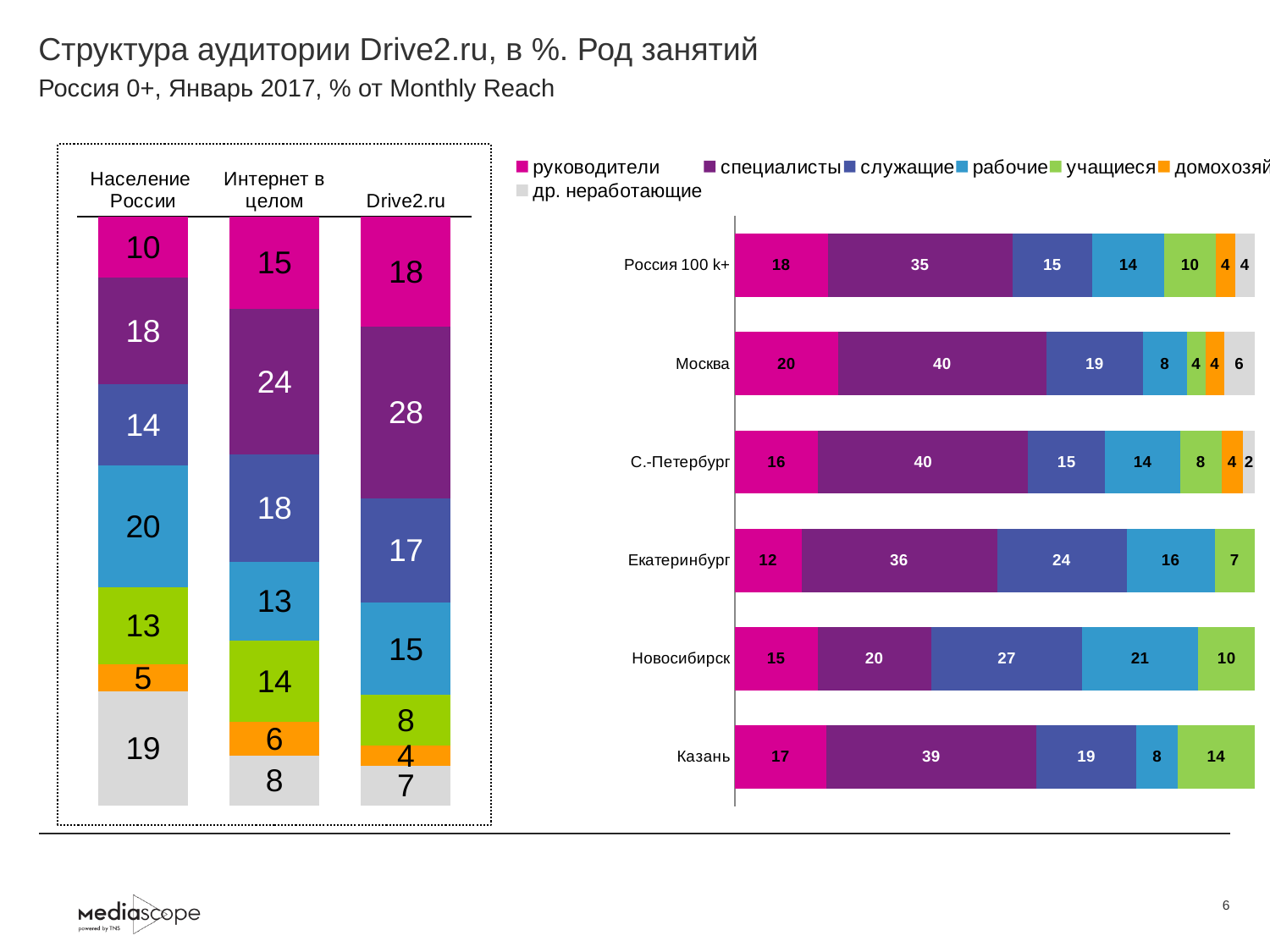
In the right chart, what is the value for специалисты in Москва? 40 In the right chart, which is larger: служащие in Новосибирск or служащие in Казань? Новосибирск What kind of chart is the right chart? Stacked bar chart In the left chart, what is the value for the др. неработающие (grey) segment of the Население России bar? 19 How many categories (rows) are shown in the right chart? 6 In the right chart, what is the difference between the рабочие values for Новосибирск and Казань? 13 In the right chart, what is the value for служащие in Екатеринбург? 24 In the left chart, what is the value for the специалисты (purple) segment of the Drive2.ru bar? 28 In the left chart, what is the difference between the руководители values for Drive2.ru and Население России? 8 In the right chart, which category has the lowest value for специалисты? Новосибирск How many series does the legend of the right chart list? 7 In the right chart, which city has the highest value for руководители? Москва